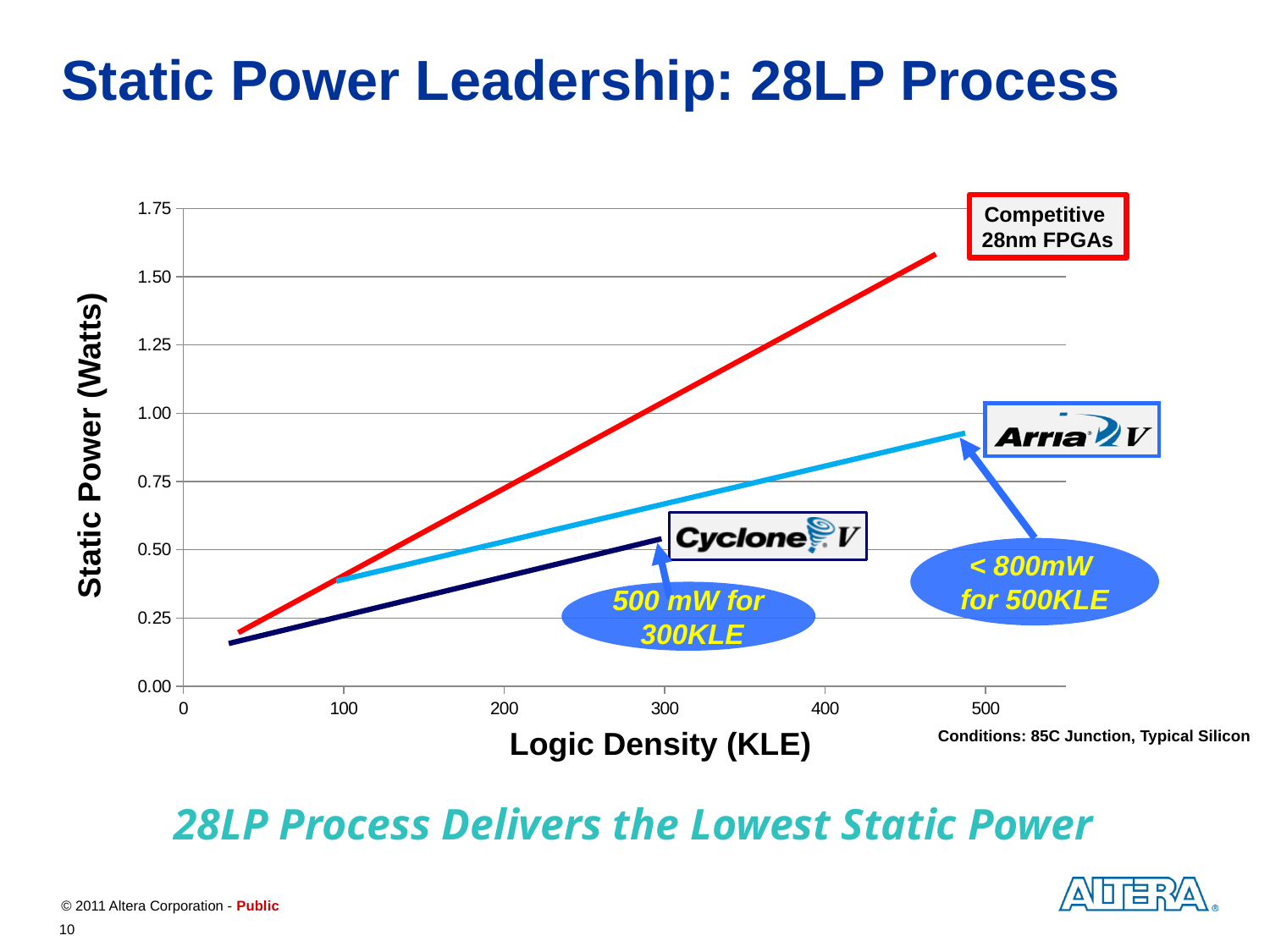
How many lines (series) are plotted on the chart? 3 What conditions are stated for the chart data? 85C Junction, Typical Silicon Which series has the lowest static power across the plotted logic densities? Cyclone V At 300 KLE, which has higher static power: Arria V or Cyclone V? Arria V What is the title of the y axis? Static Power (Watts) According to the callout on the chart, what is the static power of Cyclone V at 300 KLE? 500 mW What kind of chart is shown on the slide? line chart Is the static power of the Competitive 28nm FPGAs line at 400 KLE greater or less than 1.00 Watts? greater Do the static power values rise or fall as logic density increases? rise Which series has the highest static power at 400 KLE? Competitive 28nm FPGAs Is the static power of the Cyclone V line at 300 KLE greater or less than 0.75 Watts? less Is the static power of the Arria V line at 500 KLE greater or less than 1.00 Watts? less